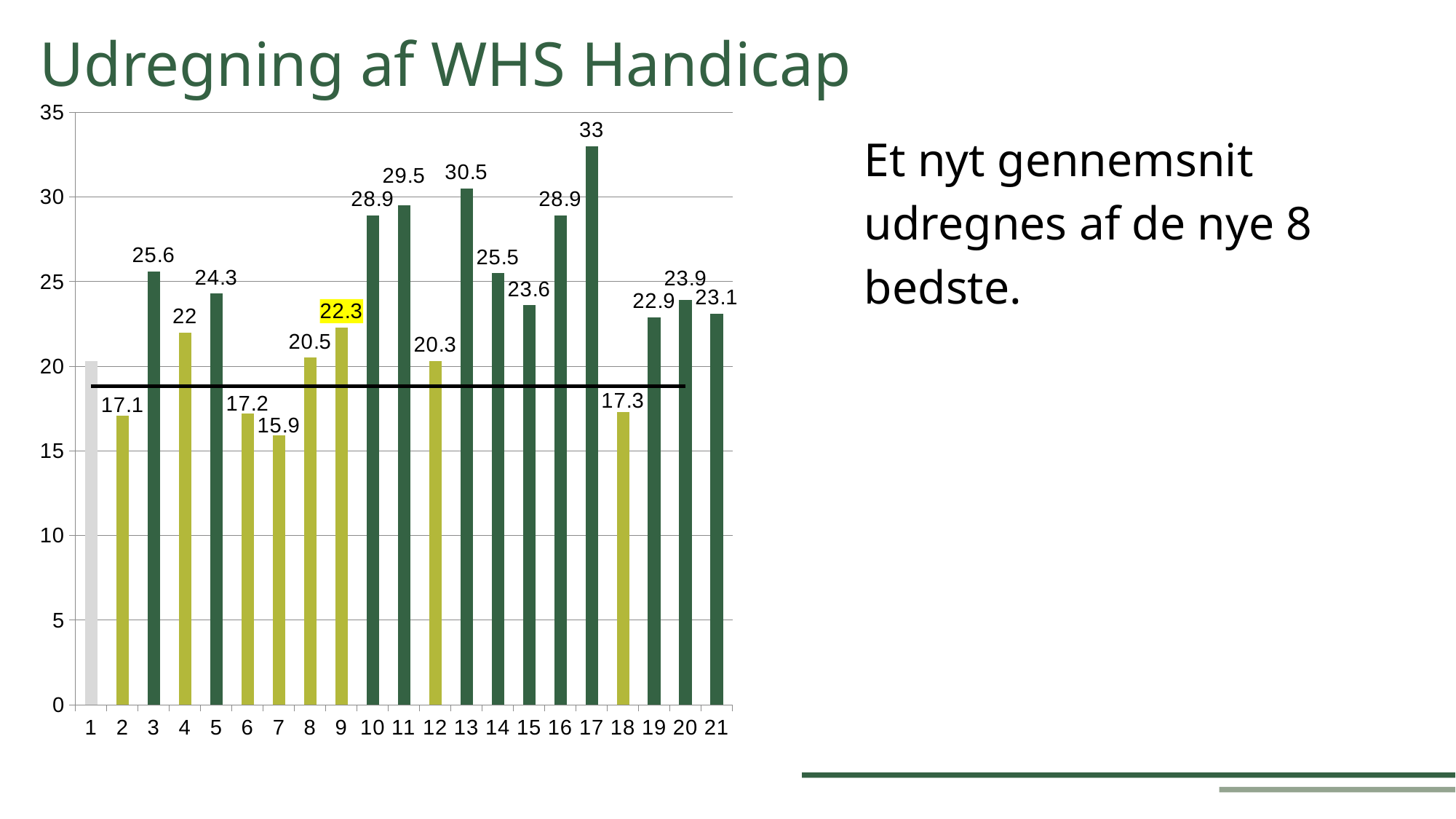
What is the difference between the values for category 17 and category 7? 17.1 What is the title of the slide containing the chart? Udregning af WHS Handicap What is the difference between the values for category 13 and category 14? 5 What kind of chart is shown on the slide? Combination bar and line chart Is the value for category 1 greater or less than 25? less How many categories are shown on the x axis? 21 Which category has the highest value? 17 Which is larger, the value for category 11 or the value for category 16? Category 11 Which category has the lowest value? 7 What is the value for category 7? 15.9 What is the value for category 17? 33 What is the value for category 9, the one with the highlighted label? 22.3